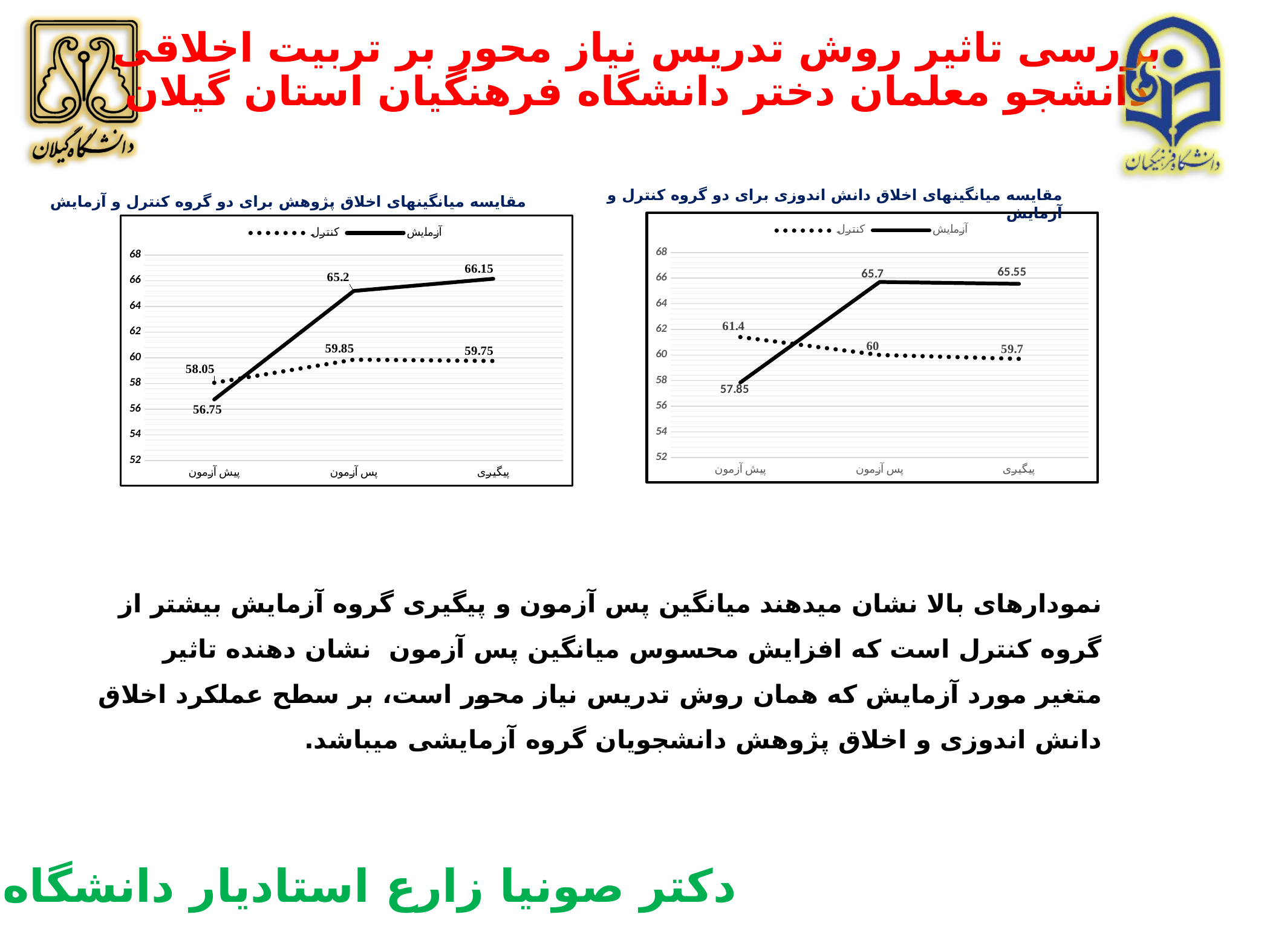
In the right chart (اخلاق دانش اندوزی), at which time point is the آزمایش (experimental) group lowest? پیش آزمون In the left chart (اخلاق پژوهش), does the کنترل (control) line rise or fall from پیش آزمون to پس آزمون? rise How many series does the legend of the right chart (اخلاق دانش اندوزی) list? 2 In the right chart (اخلاق دانش اندوزی), what is the value of the آزمایش (experimental) group at پیگیری (follow-up)? 65.55 What type of chart is the left chart (اخلاق پژوهش)? line chart In the left chart (اخلاق پژوهش), what is the difference between the آزمایش and کنترل groups at پیگیری (follow-up)? 6.4 In the right chart (اخلاق دانش اندوزی), what is the difference between the آزمایش and کنترل groups at پس آزمون (post-test)? 5.7 In the left chart (اخلاق پژوهش), what is the value of the آزمایش (experimental) group at پس آزمون (post-test)? 65.2 In the right chart (اخلاق دانش اندوزی), what is the value of the کنترل (control) group at پیش آزمون (pre-test)? 61.4 In the left chart (اخلاق پژوهش), at which time point does the آزمایش (experimental) group reach its highest value? پیگیری In the left chart (اخلاق پژوهش), what is the value of the کنترل (control) group at پیش آزمون (pre-test)? 58.05 In the right chart (اخلاق دانش اندوزی), which group has the higher value at پیش آزمون (pre-test)? کنترل